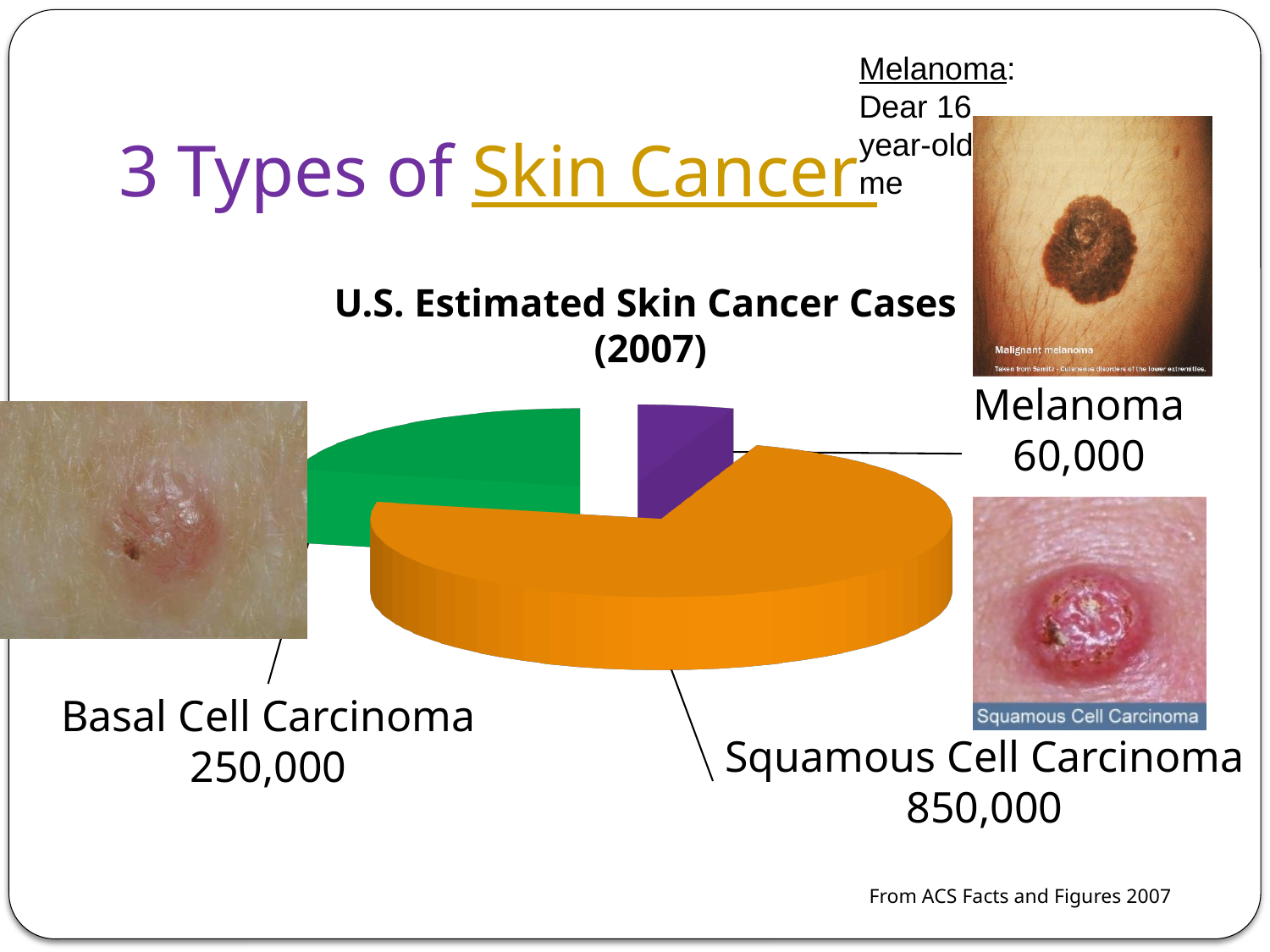
Which type of skin cancer has the highest number of estimated cases? Squamous Cell Carcinoma How many estimated cases are shown for Squamous Cell Carcinoma? 850,000 How many estimated cases are shown for Basal Cell Carcinoma? 250,000 What is the difference in estimated cases between Basal Cell Carcinoma and Melanoma? 190,000 What kind of chart is shown on the slide? Pie chart Which type of skin cancer has the lowest number of estimated cases? Melanoma What colour is the Melanoma slice of the pie chart? Purple How many categories does the pie chart show? 3 What is the title of the chart? U.S. Estimated Skin Cancer Cases (2007) What is the difference in estimated cases between Squamous Cell Carcinoma and Basal Cell Carcinoma? 600,000 Which has more estimated cases, Basal Cell Carcinoma or Melanoma? Basal Cell Carcinoma How many estimated cases are shown for Melanoma? 60,000